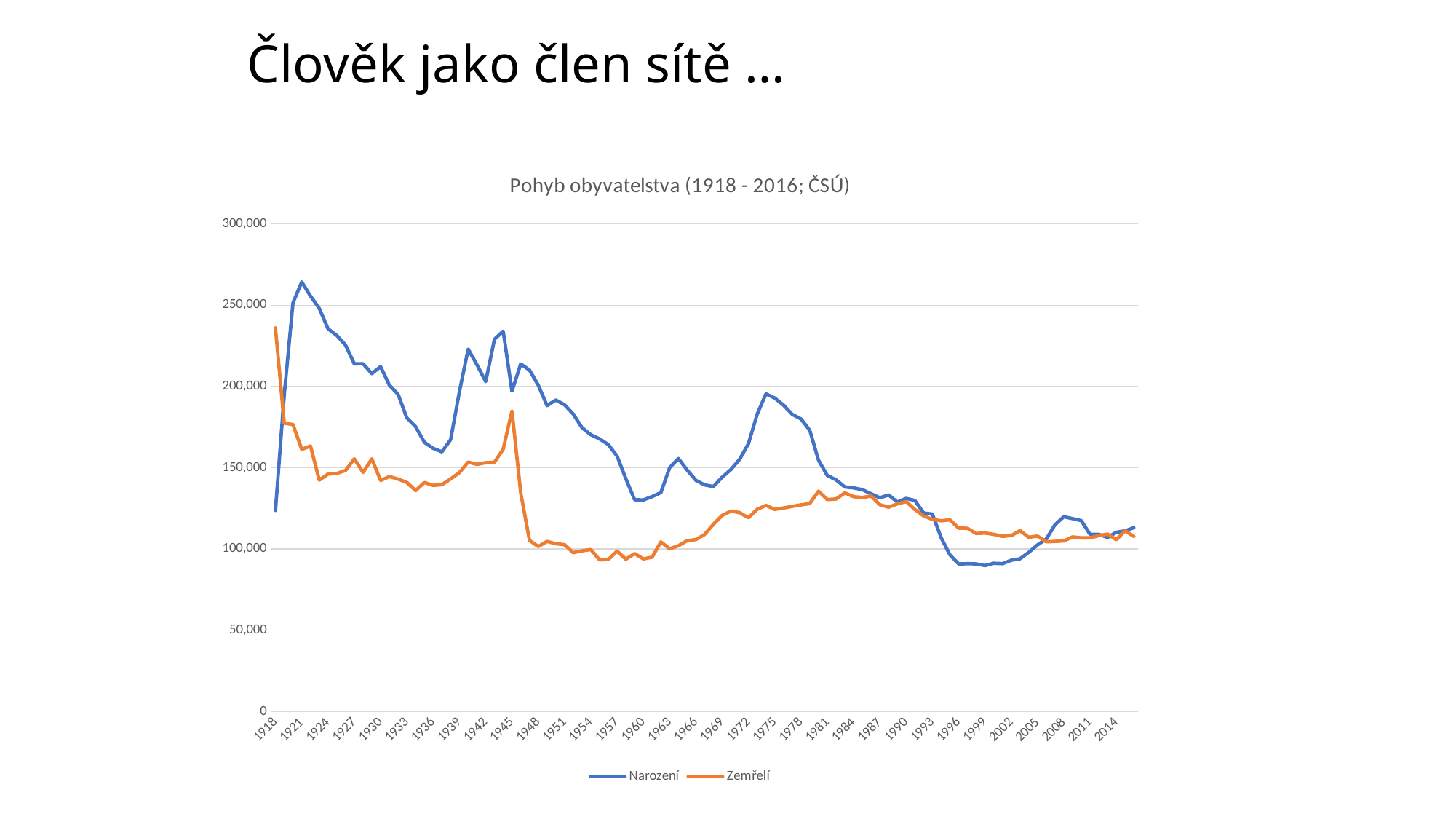
Which colour is used for the Zemřelí series? orange How many series does the legend list? 2 Is the value for Narození in 1921 greater or less than 250,000? greater In which year does the Zemřelí series reach its highest value? 1918 Which series has the larger value in 1975, Narození or Zemřelí? Narození What kind of chart is shown on the slide? line chart Does the Narození series rise or fall between 1975 and 1999? fall In which year does the Narození series reach its highest value? 1921 What is the title of the chart? Pohyb obyvatelstva (1918 - 2016; ČSÚ) Which series has the larger value in 1918, Narození or Zemřelí? Zemřelí Is the value for Narození in 1999 greater or less than 100,000? less